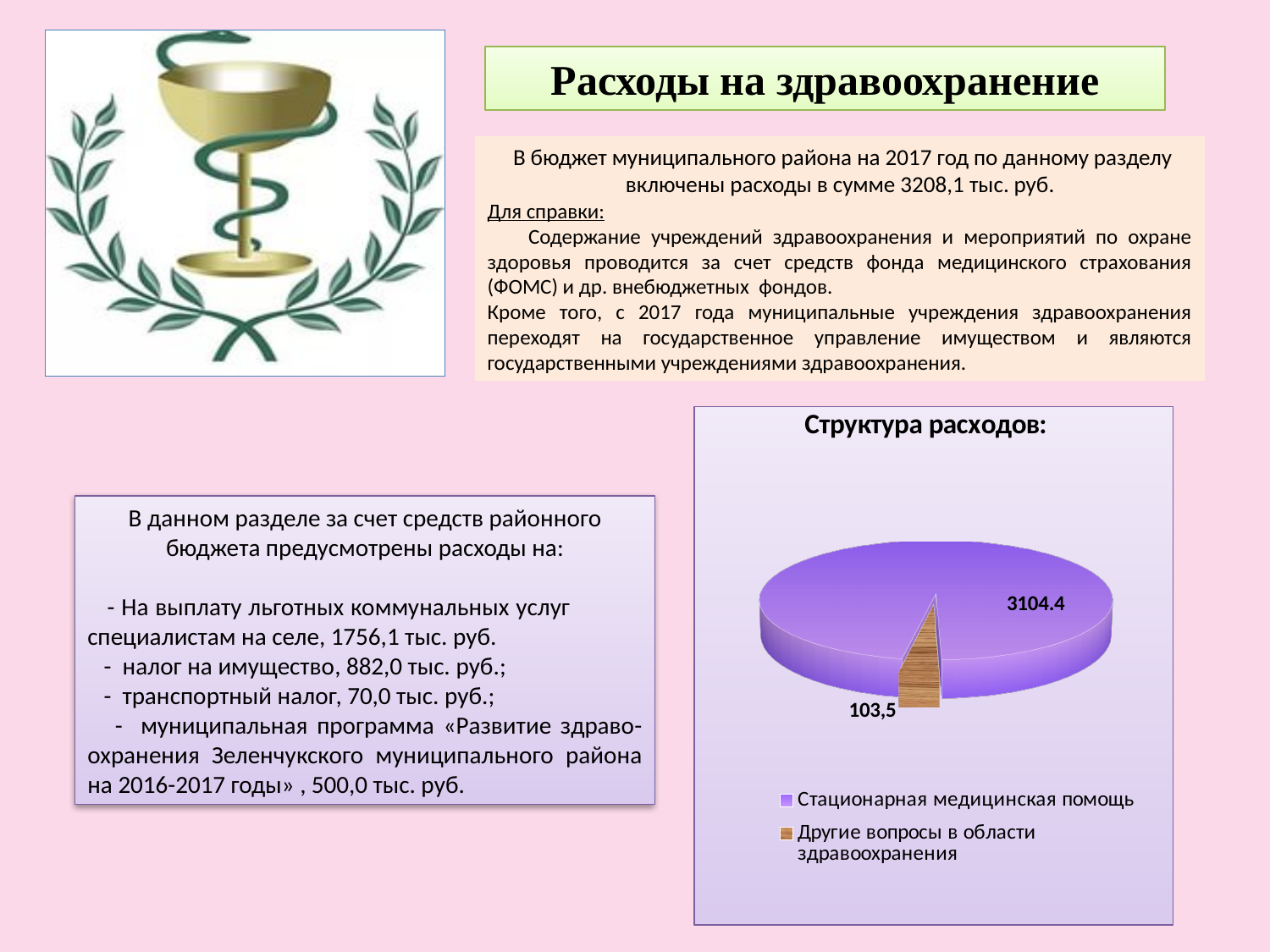
What is the sum of the two values shown in the pie chart? 3207.9 How many entries does the legend of the pie chart list? 2 What colour is the slice for "Стационарная медицинская помощь" in the pie chart? purple What is the difference between the two values shown in the pie chart? 3000.9 What kind of chart is shown under the title "Структура расходов:"? pie chart What is the title of the pie chart? Структура расходов: How many slices does the pie chart have? 2 What is the value shown for "Стационарная медицинская помощь" in the pie chart? 3104.4 Which category has the smallest slice in the pie chart? Другие вопросы в области здравоохранения What is the value shown for "Другие вопросы в области здравоохранения" in the pie chart? 103,5 Which category has the largest slice in the pie chart? Стационарная медицинская помощь Which is larger in the pie chart: "Стационарная медицинская помощь" or "Другие вопросы в области здравоохранения"? Стационарная медицинская помощь